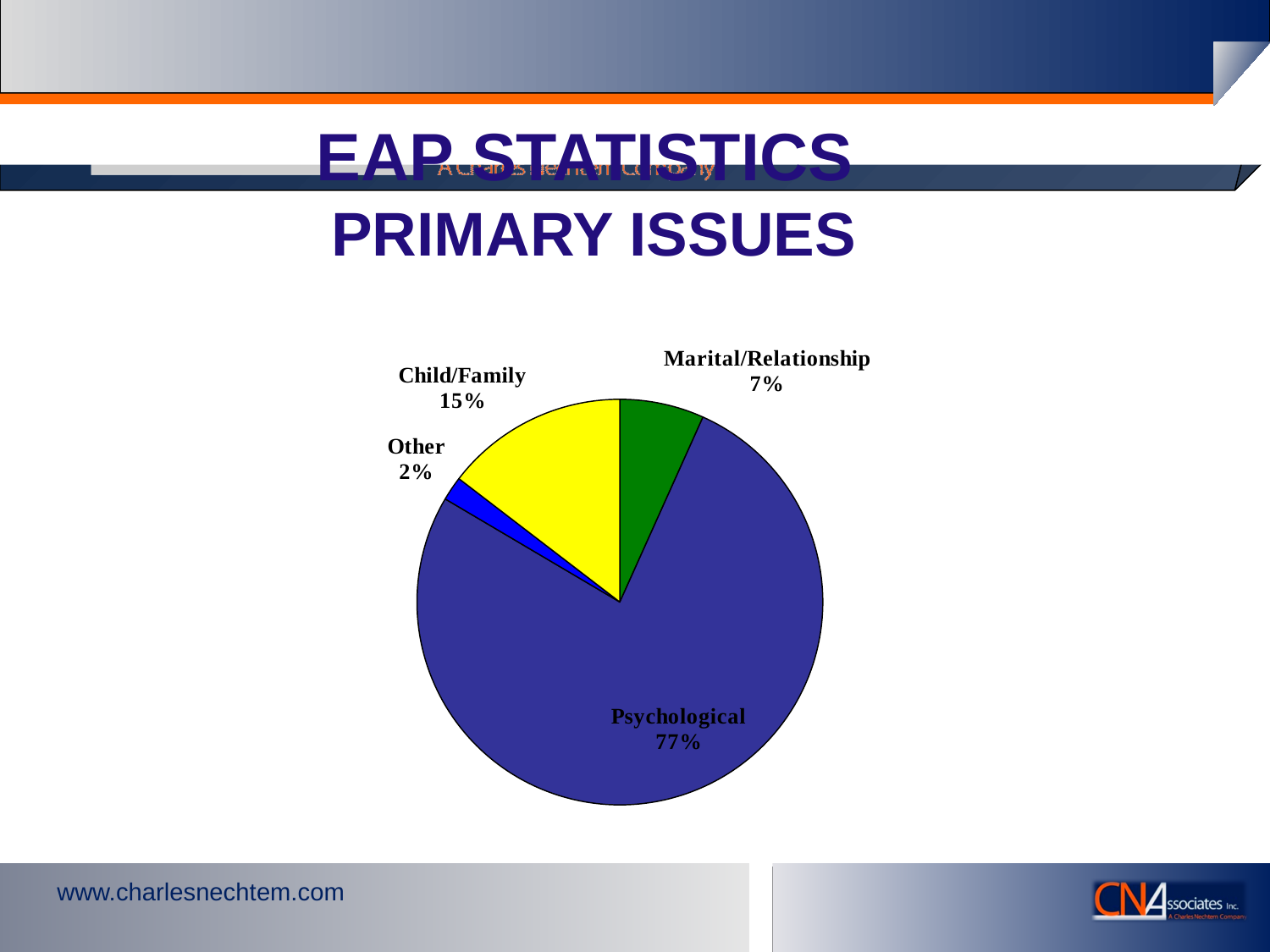
Which category has the largest slice of the pie? Psychological What colour is the Child/Family slice? yellow How many slices does the pie chart have? 4 What share of the pie does Other represent? 2% What kind of chart is shown on the slide? pie chart Which is larger, the Child/Family slice or the Marital/Relationship slice? Child/Family Which category has the smallest slice of the pie? Other What is the difference in percentage points between Child/Family and Marital/Relationship? 8 What share of the pie does Child/Family represent? 15% What share of the pie does Marital/Relationship represent? 7% What is the difference in percentage points between Psychological and Child/Family? 62